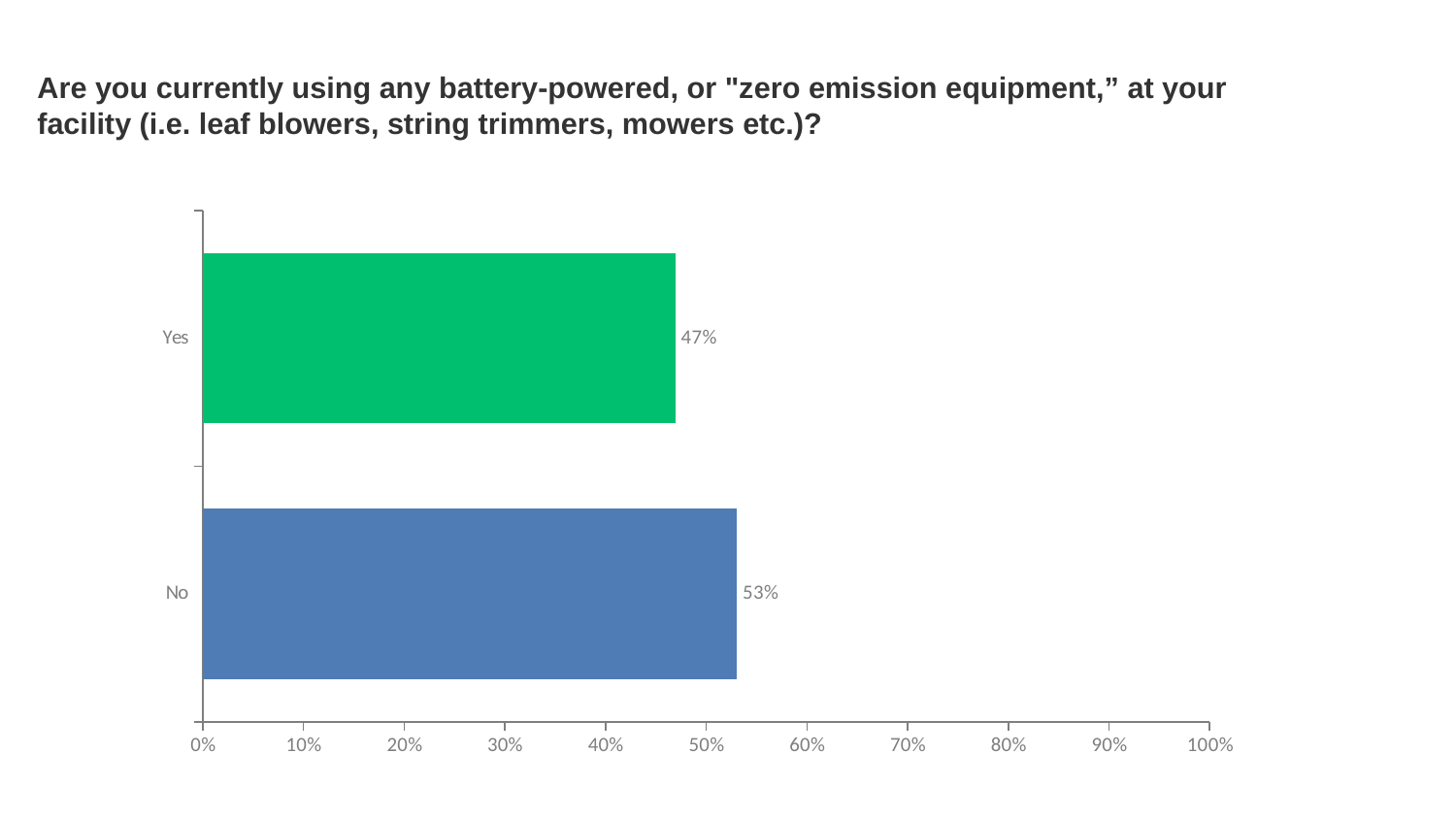
Is the value for "Yes" larger or smaller than the value for "No"? smaller What is the maximum value shown on the horizontal axis? 100% How many response categories are shown in the chart? 2 Which response has the higher percentage? No Is the value for "No" greater or less than 50%? greater What percentage of respondents answered "No"? 53% What percentage of respondents answered "Yes"? 47% What colour is the bar for the "Yes" response? Green Which response has the lower percentage? Yes What is the difference in percentage points between the "No" and "Yes" responses? 6 percentage points Is the value for "Yes" greater or less than 50%? less What kind of chart is shown on the slide? Bar chart